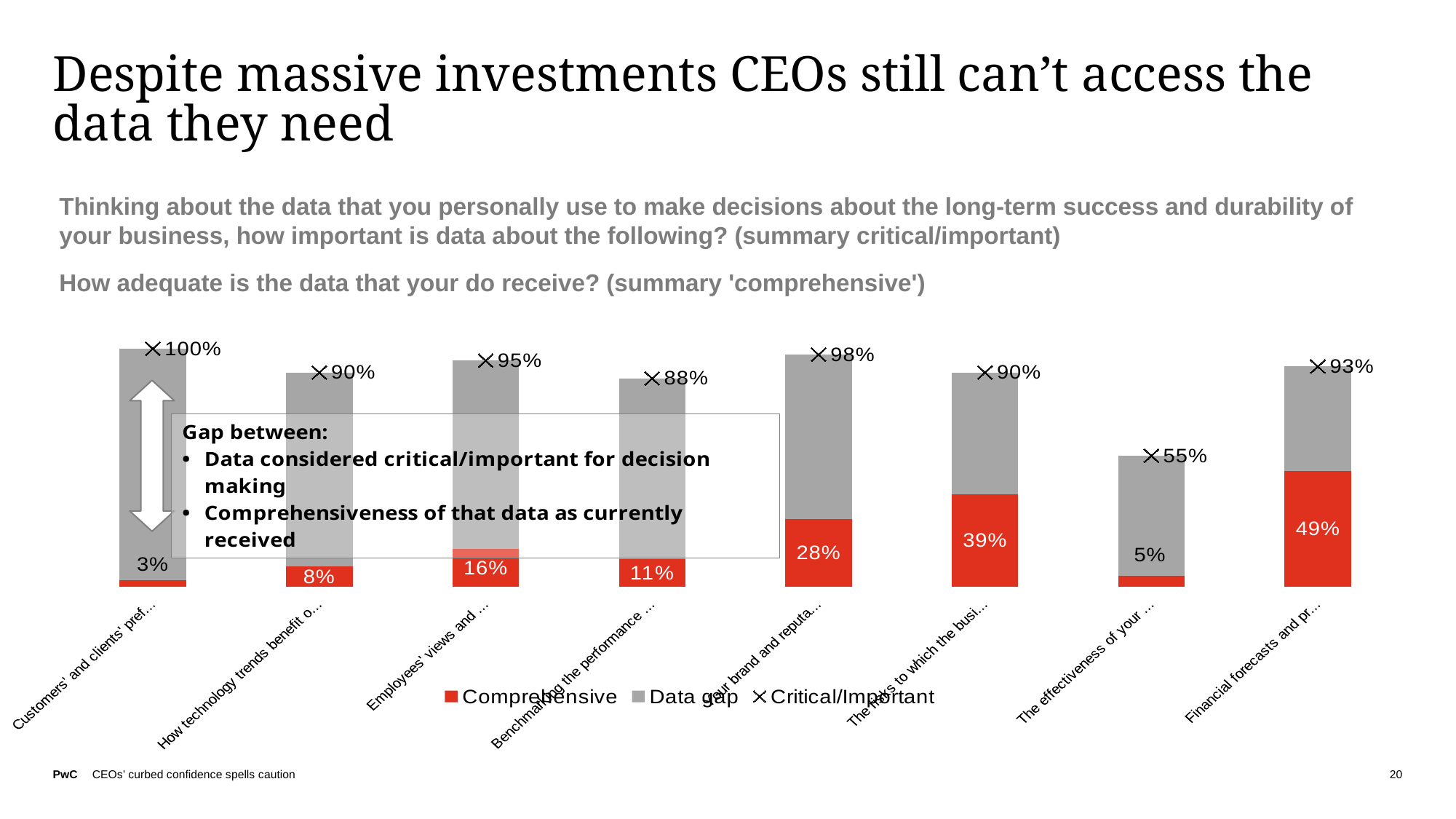
For the last bar, 'Financial forecasts and pr...', what is the difference between the Critical/Important value and the Comprehensive value? 44 percentage points What is the Comprehensive value for the bar labelled 'How technology trends benefit o...'? 8% Which category has the lowest Critical/Important value? The effectiveness of your ... (55%) What marker symbol does the legend use for the Critical/Important series? an X (cross) marker What is the Comprehensive value for the last bar, 'Financial forecasts and pr...'? 49% Which category has the lowest Comprehensive value? Customers' and clients' pref... (3%) How many series does the chart legend list? 3 How many categories (bars) are plotted in the chart? 8 Which has the larger Comprehensive value: the bar labelled '...our brand and reputa...' or the bar labelled 'The ... to which the busi...'? The ... to which the busi... (39%) What kind of chart is shown on the slide? bar chart Which category has the highest Comprehensive value? Financial forecasts and pr... (49%) What is the Critical/Important value for the first bar, 'Customers' and clients' pref...'? 100%